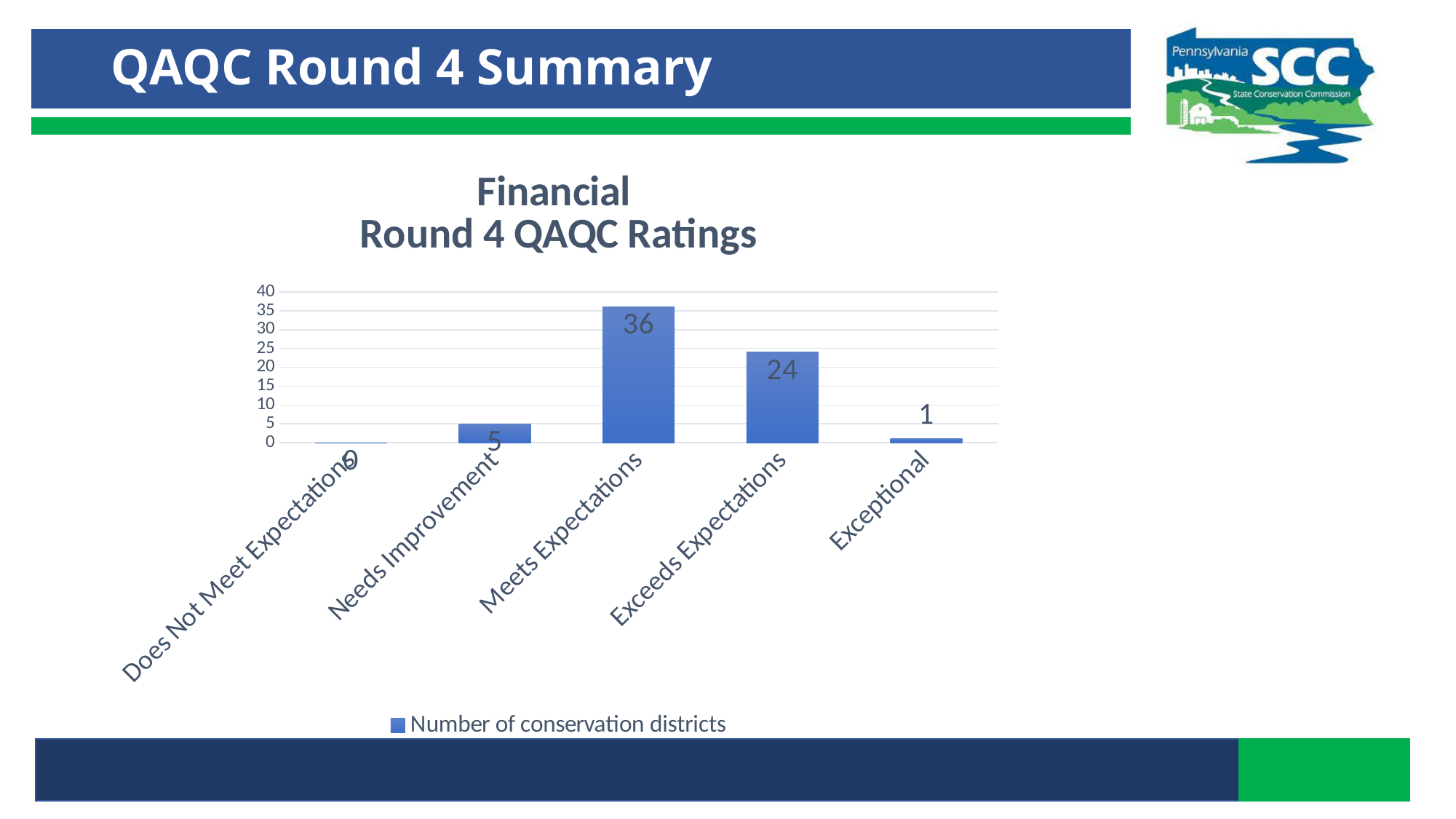
Which rating category has the highest number of conservation districts? Meets Expectations What is the number of conservation districts rated Needs Improvement? 5 Is the value for Exceeds Expectations greater or less than 20? greater How many rating categories are shown on the x axis? 5 What is the number of conservation districts rated Meets Expectations? 36 What is the number of conservation districts rated Exceptional? 1 How many series does the legend list? 1 What is the title of the chart? Financial Round 4 QAQC Ratings What is the difference between the number of districts rated Meets Expectations and Exceeds Expectations? 12 What is the number of conservation districts rated Exceeds Expectations? 24 What kind of chart is shown on the slide? Bar chart Which has more conservation districts: Needs Improvement or Exceptional? Needs Improvement